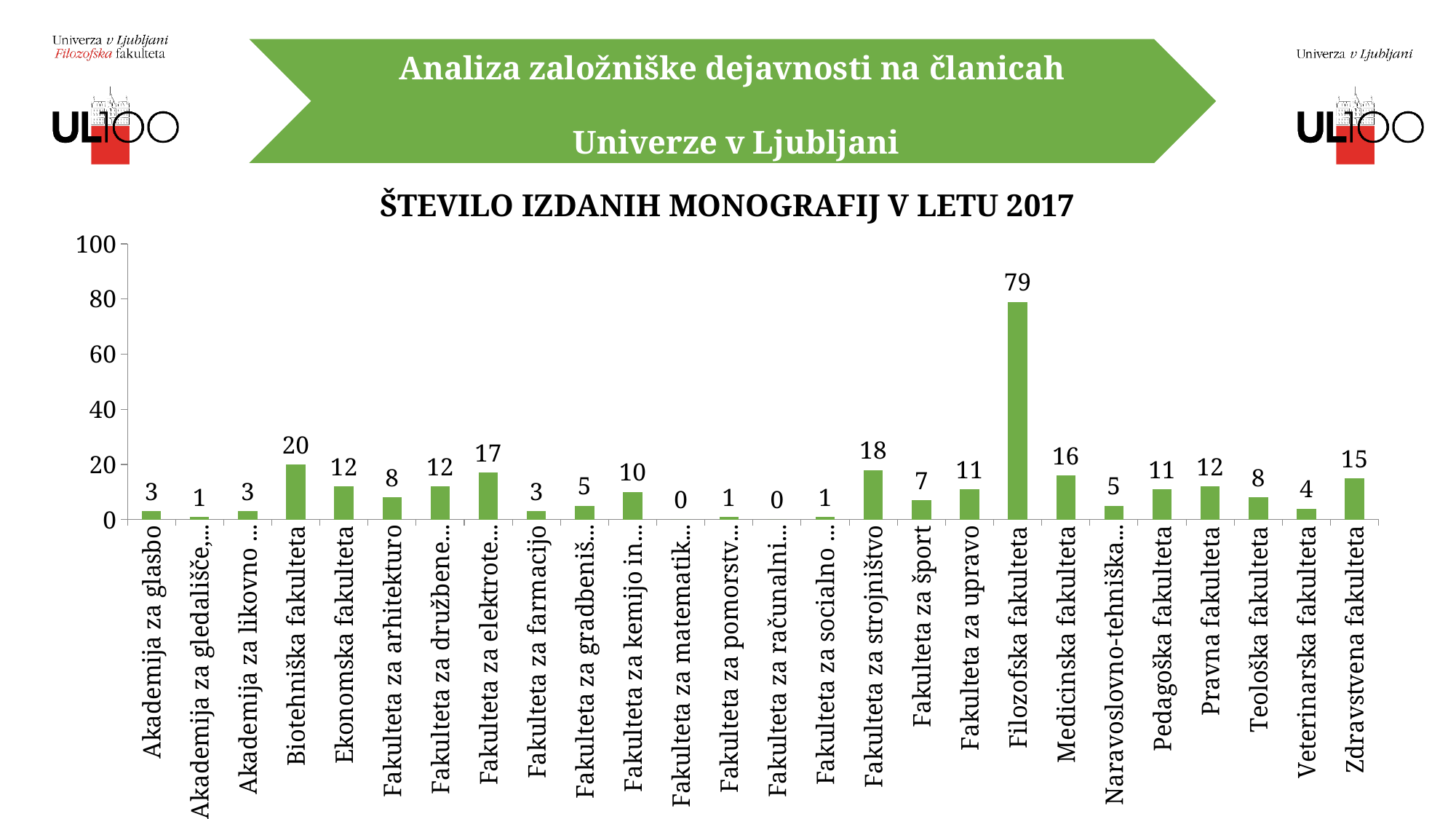
Which category has the highest value? Filozofska fakulteta How many categories are shown on the x axis? 26 What is the value for Biotehniška fakulteta? 20 What is the difference between the values for Medicinska fakulteta and Veterinarska fakulteta? 12 What kind of chart is shown on the slide? bar chart What is the value for Fakulteta za strojništvo? 18 Which is larger, the value for Fakulteta za upravo or the value for Pravna fakulteta? Pravna fakulteta What is the difference between the values for Filozofska fakulteta and Biotehniška fakulteta? 59 What is the title of the chart? ŠTEVILO IZDANIH MONOGRAFIJ V LETU 2017 What is the value for Zdravstvena fakulteta? 15 What is the value for Filozofska fakulteta? 79 Is the value for Filozofska fakulteta greater or less than 60? greater